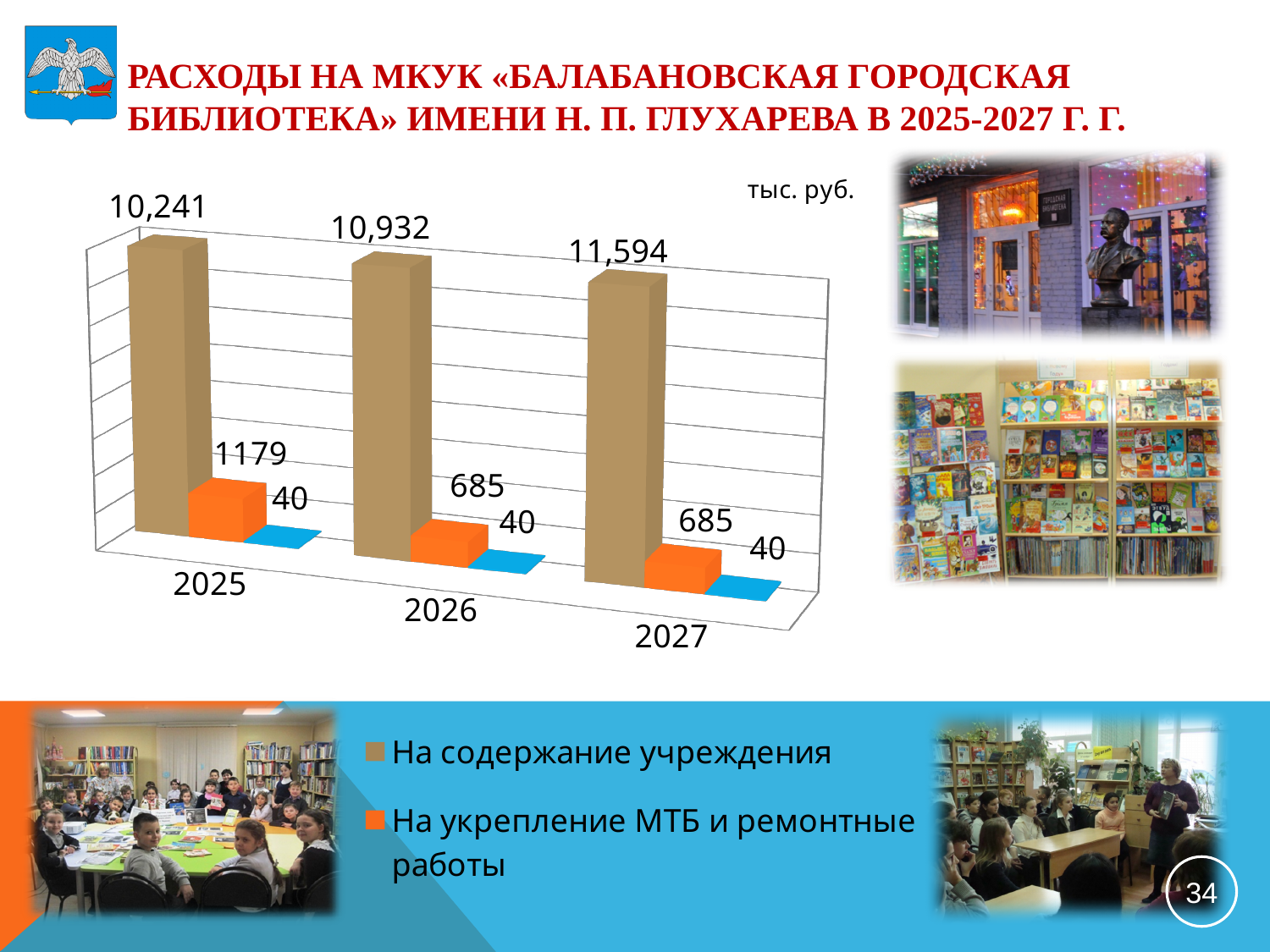
What is the value for "На содержание учреждения" in 2027? 11,594 What is the value for "На содержание учреждения" in 2025? 10,241 What is the value for "На укрепление МТБ и ремонтные работы" in 2026? 685 In which year is the value for "На содержание учреждения" lowest? 2025 What is the difference between the "На укрепление МТБ и ремонтные работы" values for 2025 and 2026? 494 What is the value for "На укрепление МТБ и ремонтные работы" in 2025? 1179 Does the value for "На содержание учреждения" rise or fall from 2025 to 2027? rise Which is larger: "На укрепление МТБ и ремонтные работы" in 2025 or in 2027? 2025 In which year is the value for "На содержание учреждения" highest? 2027 What unit is indicated above the chart? тыс. руб. What is the difference between the "На содержание учреждения" values for 2027 and 2026? 662 How many years are shown on the x axis of the chart? 3